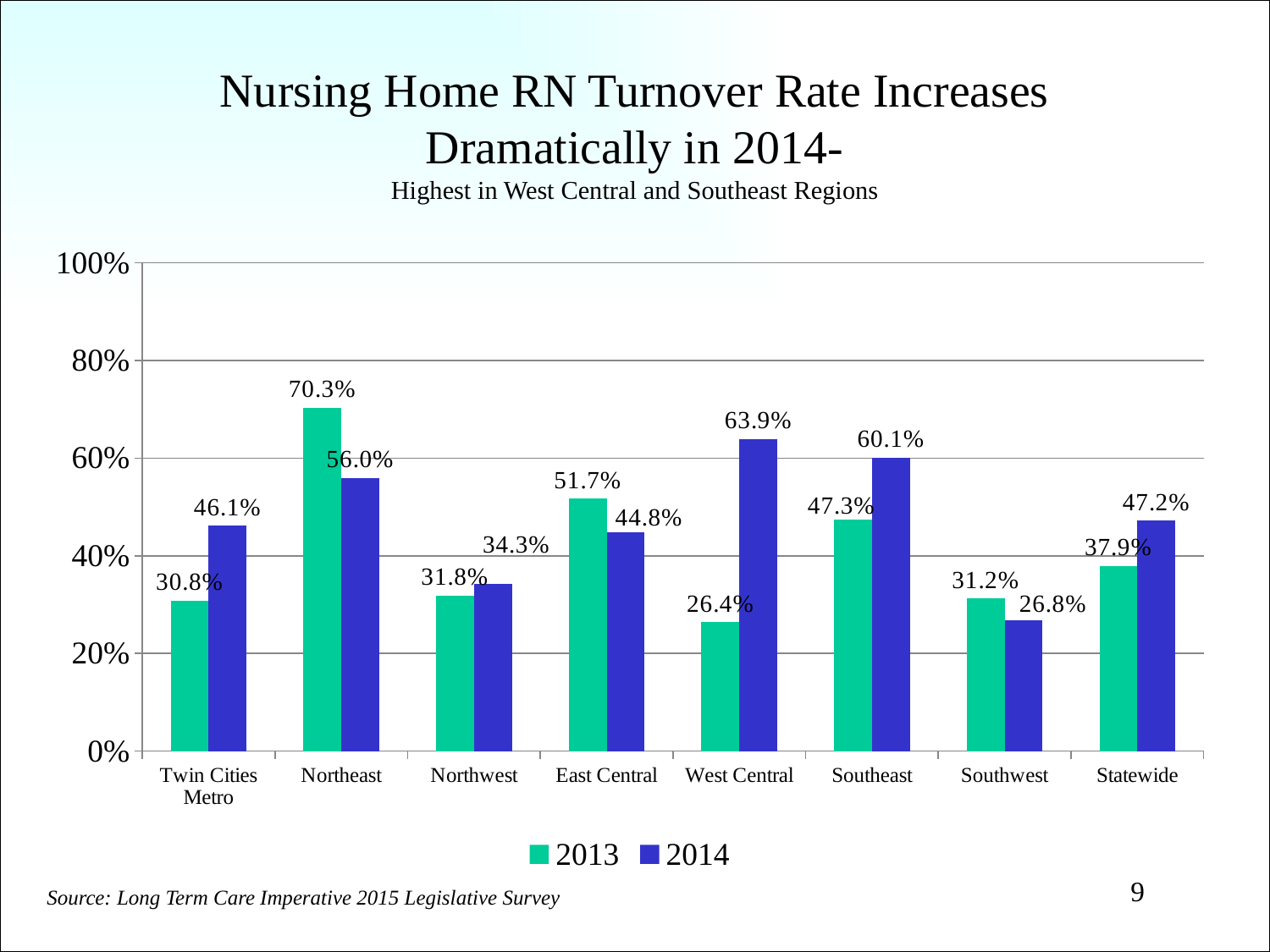
Which was larger for Northeast: the 2013 rate or the 2014 rate? 2013 What kind of chart is shown on the slide? Bar chart Which region had the highest RN turnover rate in 2014? West Central What is the difference between the 2014 and 2013 RN turnover rates for West Central? 37.5% How many series does the legend list? 2 How many regions (categories) are shown on the x axis? 8 Which region had the lowest RN turnover rate in 2014? Southwest What was the RN turnover rate for West Central in 2014? 63.9% What was the Statewide RN turnover rate in 2014? 47.2% What was the RN turnover rate for Northeast in 2013? 70.3% Which region had the lowest RN turnover rate in 2013? West Central Which colour represents 2014 in the chart? Blue